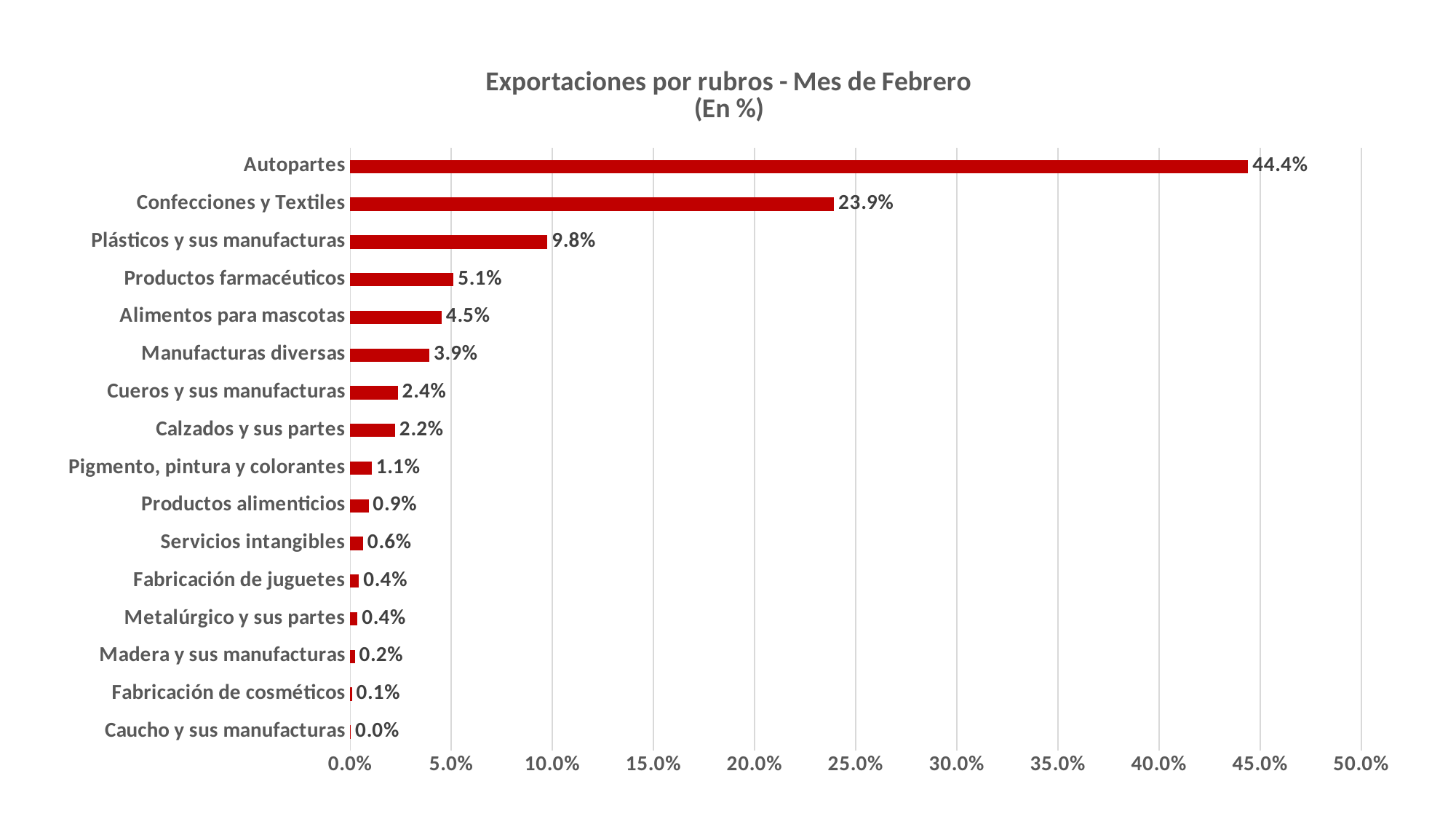
What colour are the bars in the chart? Red What is the value for Plásticos y sus manufacturas? 9.8% What is the value for Cueros y sus manufacturas? 2.4% What is the difference between the values for Autopartes and Confecciones y Textiles? 20.5% Which category has the highest value? Autopartes What kind of chart is shown on the slide? Bar chart Which is larger, the value for Productos farmacéuticos or the value for Alimentos para mascotas? Productos farmacéuticos Which category has the lowest value? Caucho y sus manufacturas What is the value for Autopartes? 44.4% How many categories are shown in the chart? 16 What is the title of the chart? Exportaciones por rubros - Mes de Febrero (En %) Is the value for Confecciones y Textiles greater or less than 25.0%? less